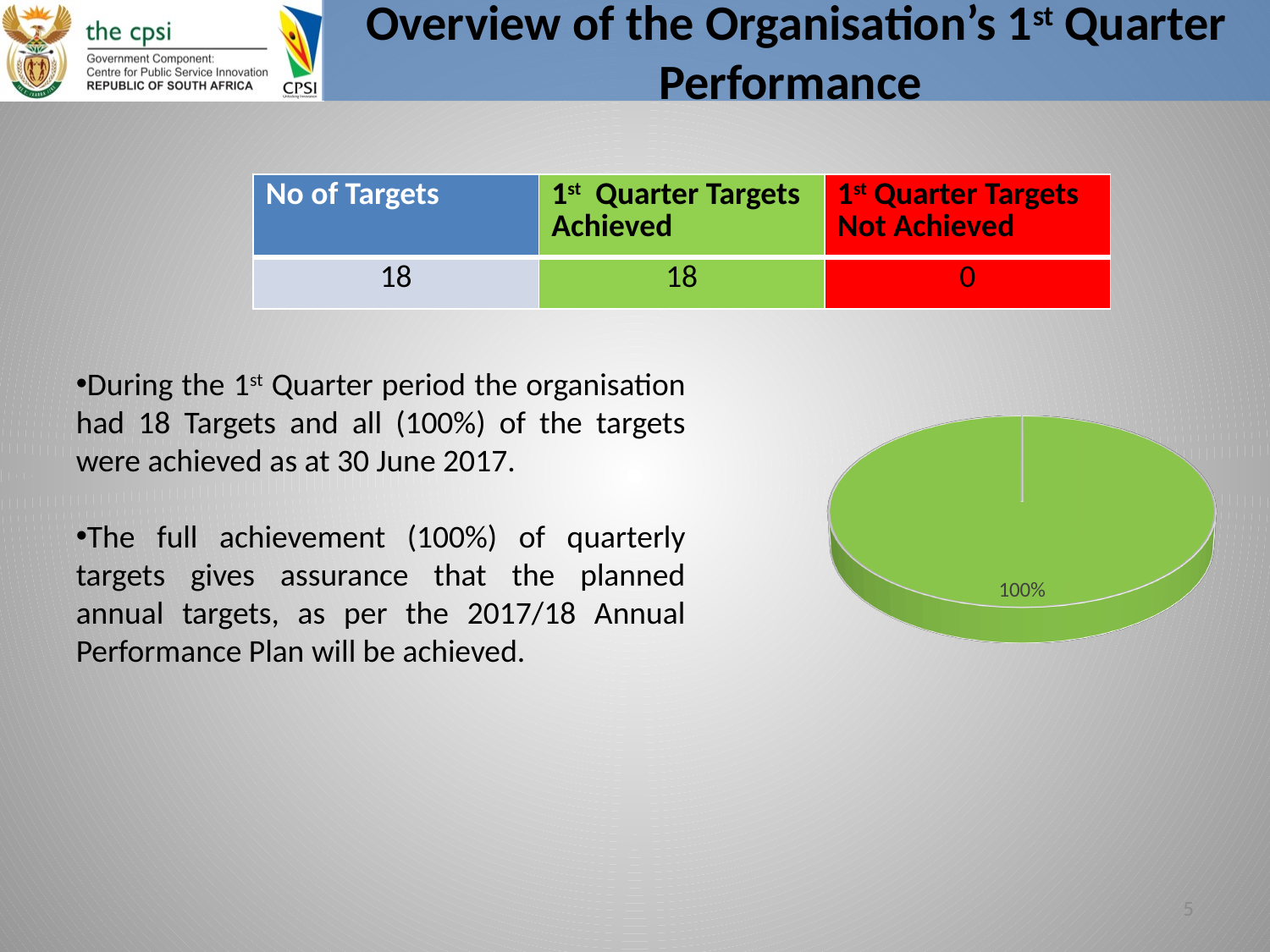
How many slices are visible in the pie chart? 1 What percentage is printed on the data label of the pie chart? 100% Does the pie chart display a legend? No What colour is the slice in the pie chart? green What share of the pie does the single visible slice take up? 100% What kind of chart is shown on the slide? pie chart